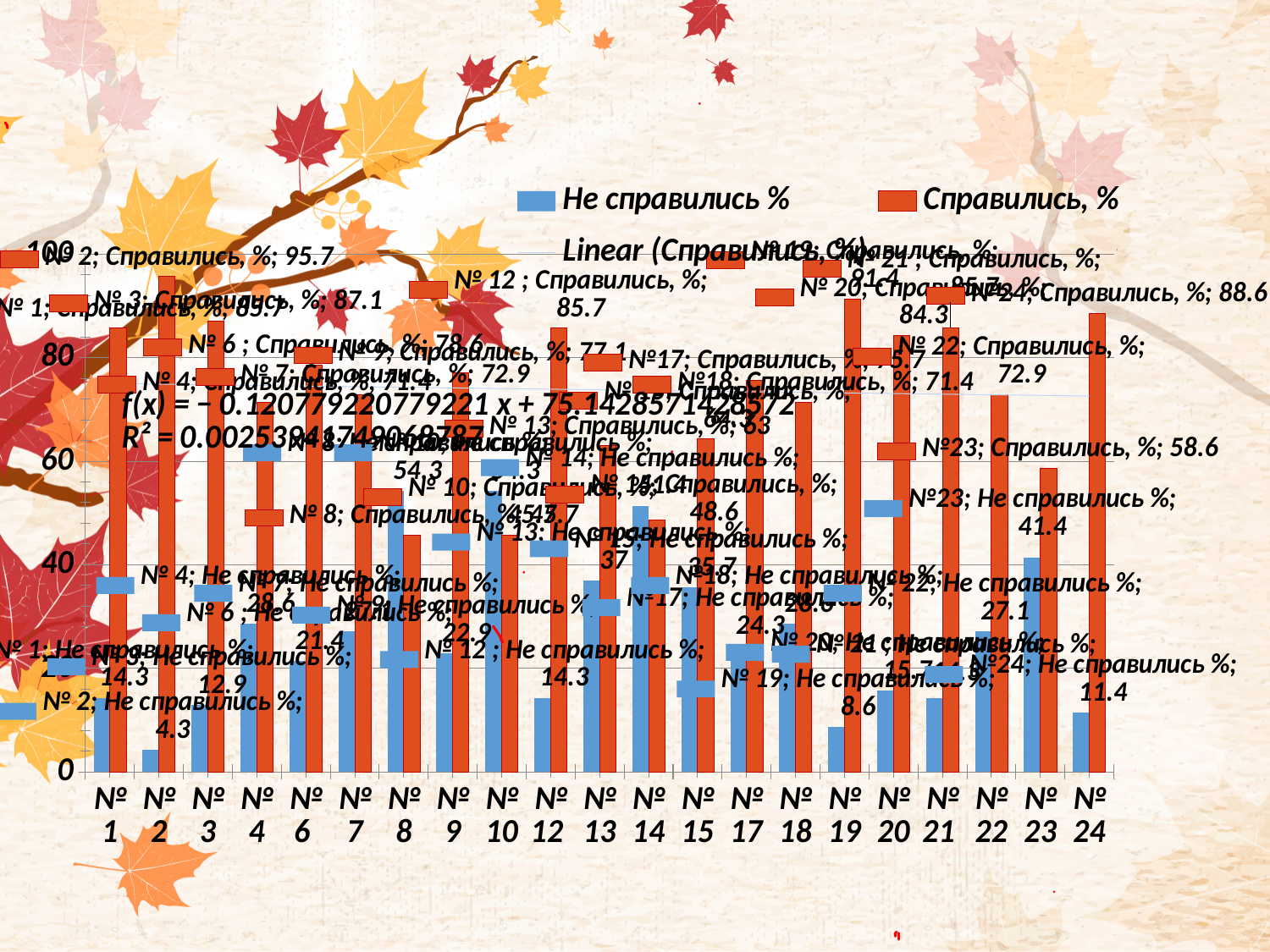
What kind of chart is shown on the slide? bar chart What is the value of 'Справились, %' for № 19? 91.4 What is the value of 'Не справились %' for № 2? 4.3 Is the 'Справились, %' value for № 20 greater or less than 80? greater Which category has the lowest 'Не справились %' value? № 2 What is the value of 'Не справились %' for № 23? 41.4 How many entries does the chart legend list? 3 Which category has the highest 'Справились, %' value? № 2 What is the difference between the 'Справились, %' values for № 24 (88.6) and № 23 (58.6)? 30 How many categories are shown along the x axis of the chart? 21 Which is larger: 'Справились, %' for № 13 or 'Справились, %' for № 14? № 13 What is the value of 'Справились, %' for № 2? 95.7